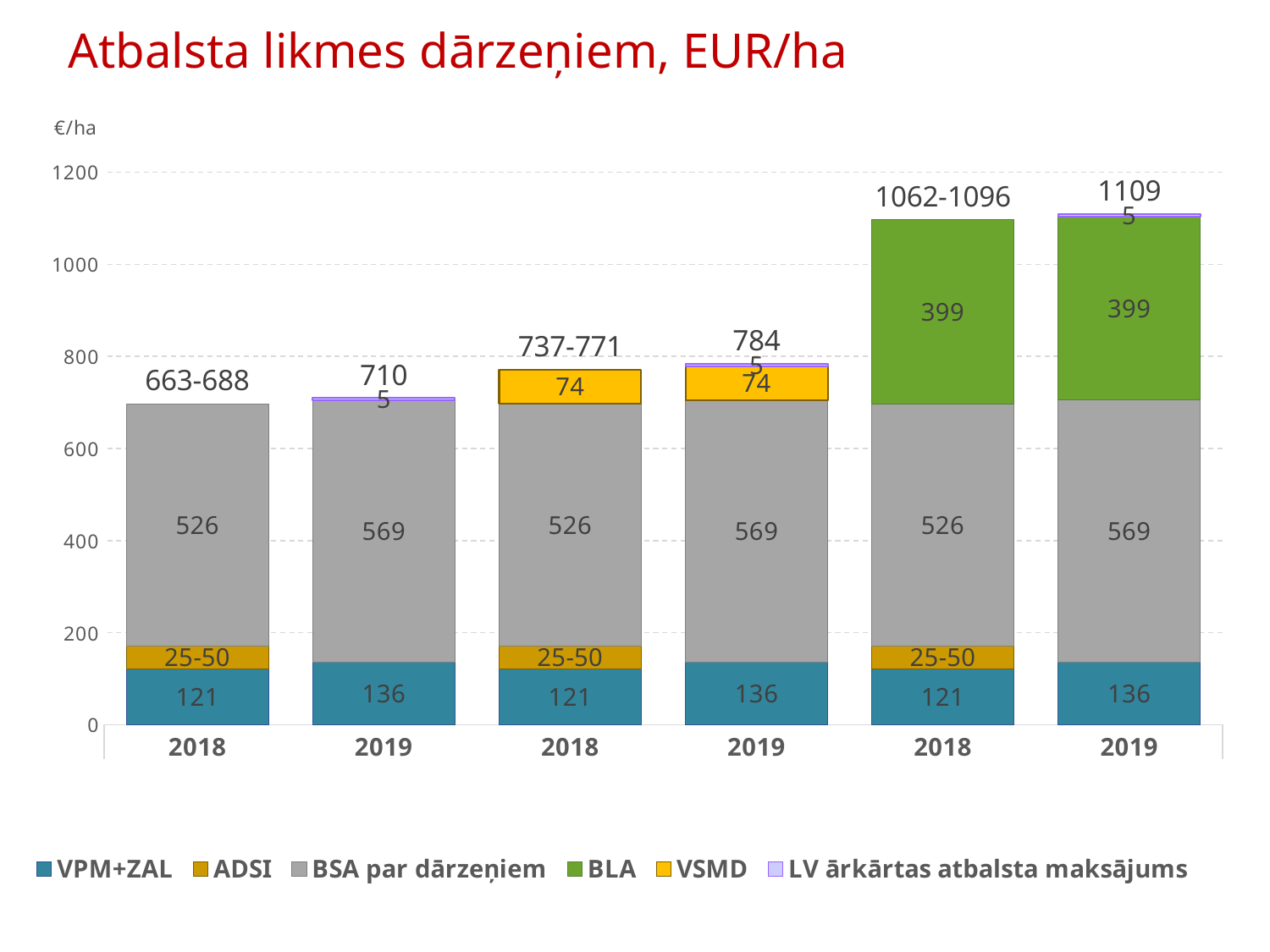
How many series does the legend list? 6 What is the difference between the BSA par dārzeņiem values in the 2019 bars and the 2018 bars? 43 What is the total printed above the rightmost bar (the third 2019 bar)? 1109 What kind of chart is shown on the slide? stacked bar chart Which bar has the highest total? the rightmost 2019 bar (1109) What is the VPM+ZAL value in the third bar from the left (the second 2018 bar)? 121 What is the BSA par dārzeņiem value in the second bar from the left (the first 2019 bar)? 569 What is the total printed above the leftmost bar (the first 2018 bar)? 663-688 How many bars are plotted in the chart? 6 What is the title of the chart? Atbalsta likmes dārzeņiem, EUR/ha What is the VSMD value in the fourth bar from the left (the second 2019 bar)? 74 What is the BLA value in the rightmost 2019 bar? 399